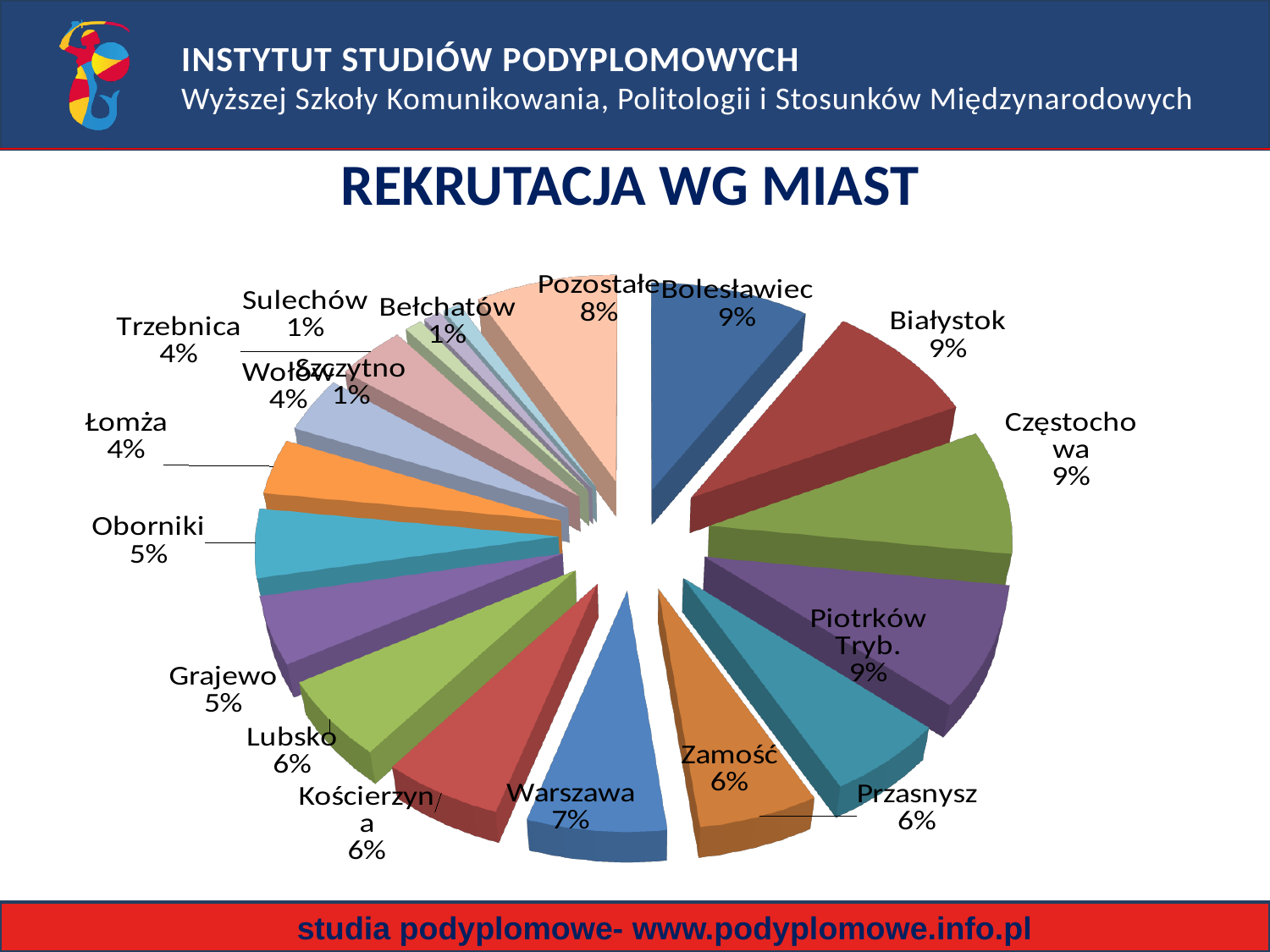
What is the value for Łomża? 4% What is the title of the chart? REKRUTACJA WG MIAST What percentage is shown for Pozostałe? 8% What is the value for Oborniki? 5% How many slices does the pie chart have? 18 What percentage is shown for Szczytno? 1% What kind of chart is shown on the slide? Pie chart What is the difference between Bolesławiec and Warszawa? 2 percentage points Which is larger, Warszawa or Zamość? Warszawa Which is larger, Lubsko or Grajewo? Lubsko What share of the pie does Warszawa have? 7% What share does Piotrków Tryb. have? 9%